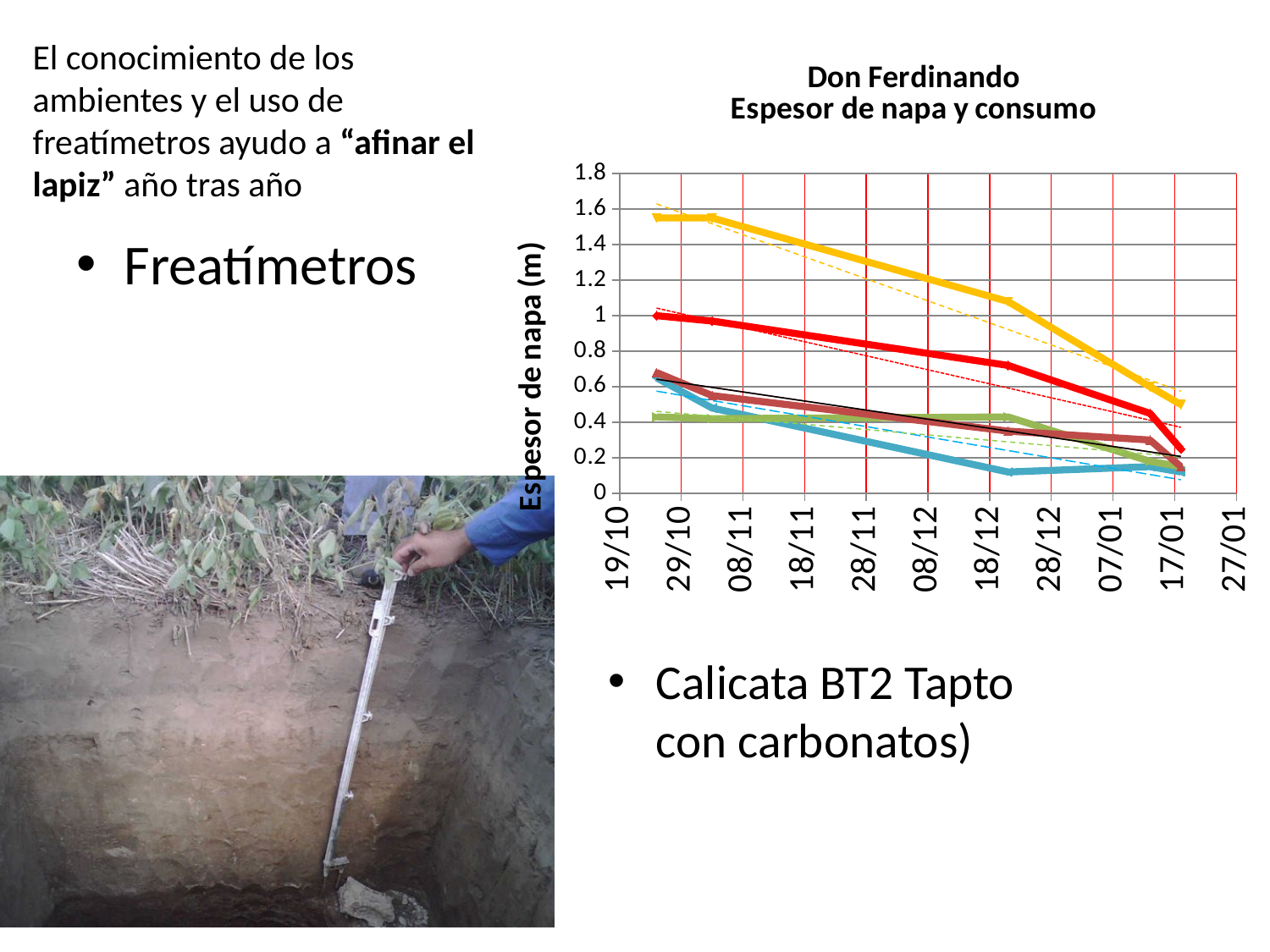
Do the solid lines in the chart rise or fall from left to right along the date axis? fall Is the value of the blue line at 18/12 greater or less than 0.2? less How many date labels are shown along the x axis of the chart? 11 Is the value of the red line at 18/12 greater or less than 0.6? greater Is the value of the yellow line at 29/10 greater or less than 1.4? greater What is the label of the vertical axis of the chart? Espesor de napa (m) What is the title of the chart on the slide? Don Ferdinando Espesor de napa y consumo How many solid (non-dashed) lines are plotted in the chart? 6 What kind of chart is shown under the title "Don Ferdinando Espesor de napa y consumo"? line chart What is the highest value shown on the vertical axis of the chart? 1.8 Which coloured line has the highest values throughout the chart? the yellow line